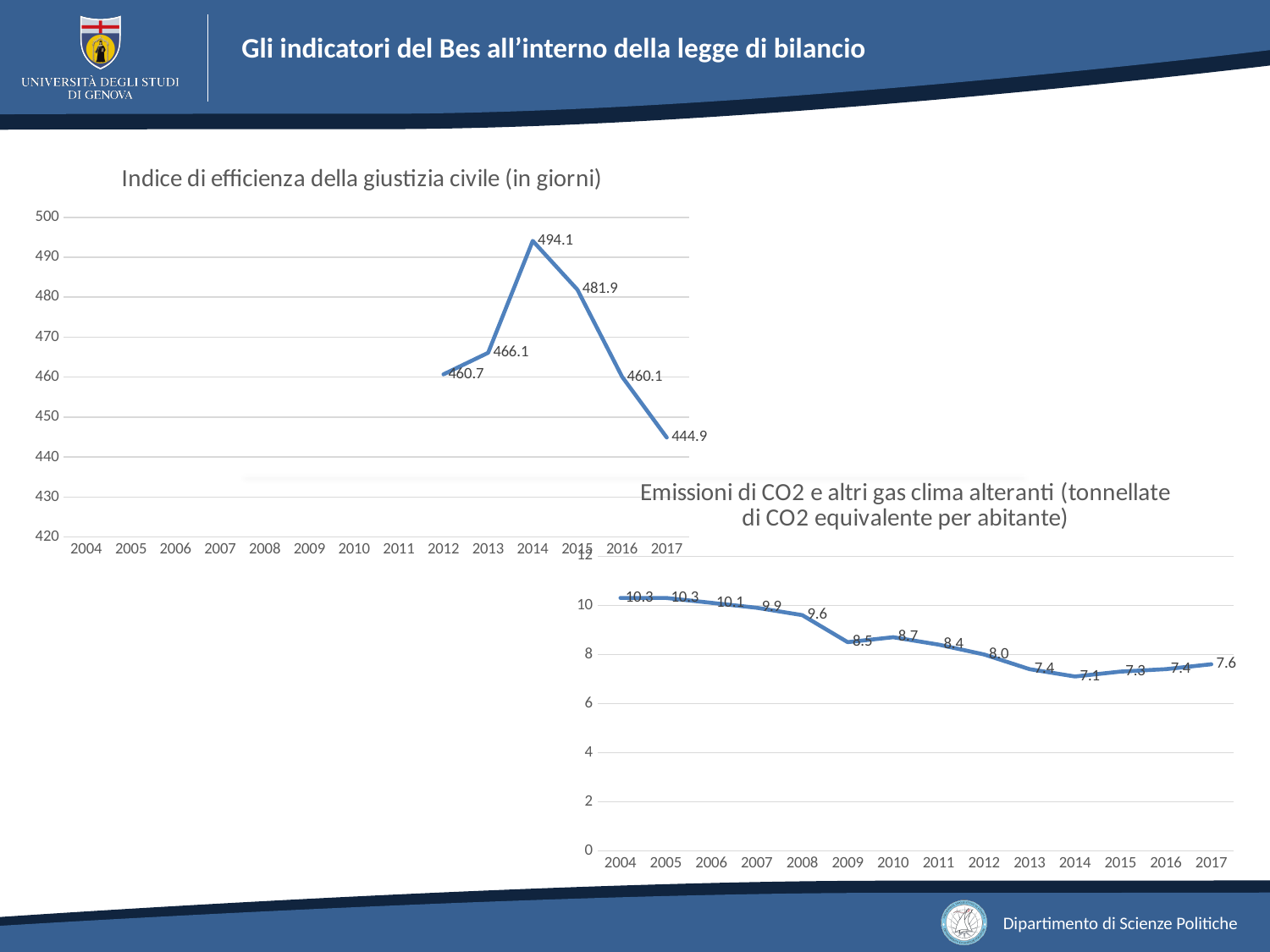
In the chart 'Indice di efficienza della giustizia civile (in giorni)', what is the value for 2014? 494.1 In the chart 'Emissioni di CO2 e altri gas clima alteranti', which year has the lowest value? 2014 In the chart 'Emissioni di CO2 e altri gas clima alteranti', what is the difference between the values for 2004 and 2017? 2.7 In the chart 'Indice di efficienza della giustizia civile (in giorni)', what type of chart is shown? Line chart In the chart 'Emissioni di CO2 e altri gas clima alteranti', how many years are plotted on the x axis? 14 In the chart 'Indice di efficienza della giustizia civile (in giorni)', what is the difference between the values for 2014 and 2015? 12.2 In the chart 'Indice di efficienza della giustizia civile (in giorni)', which year has the lowest value? 2017 In the chart 'Emissioni di CO2 e altri gas clima alteranti', is the value for 2008 larger or smaller than the value for 2012? Larger In the chart 'Emissioni di CO2 e altri gas clima alteranti', what is the value for 2014? 7.1 In the chart 'Indice di efficienza della giustizia civile (in giorni)', which year has the highest value? 2014 In the chart 'Indice di efficienza della giustizia civile (in giorni)', what is the value for 2017? 444.9 In the chart 'Emissioni di CO2 e altri gas clima alteranti', what is the value for 2009? 8.5